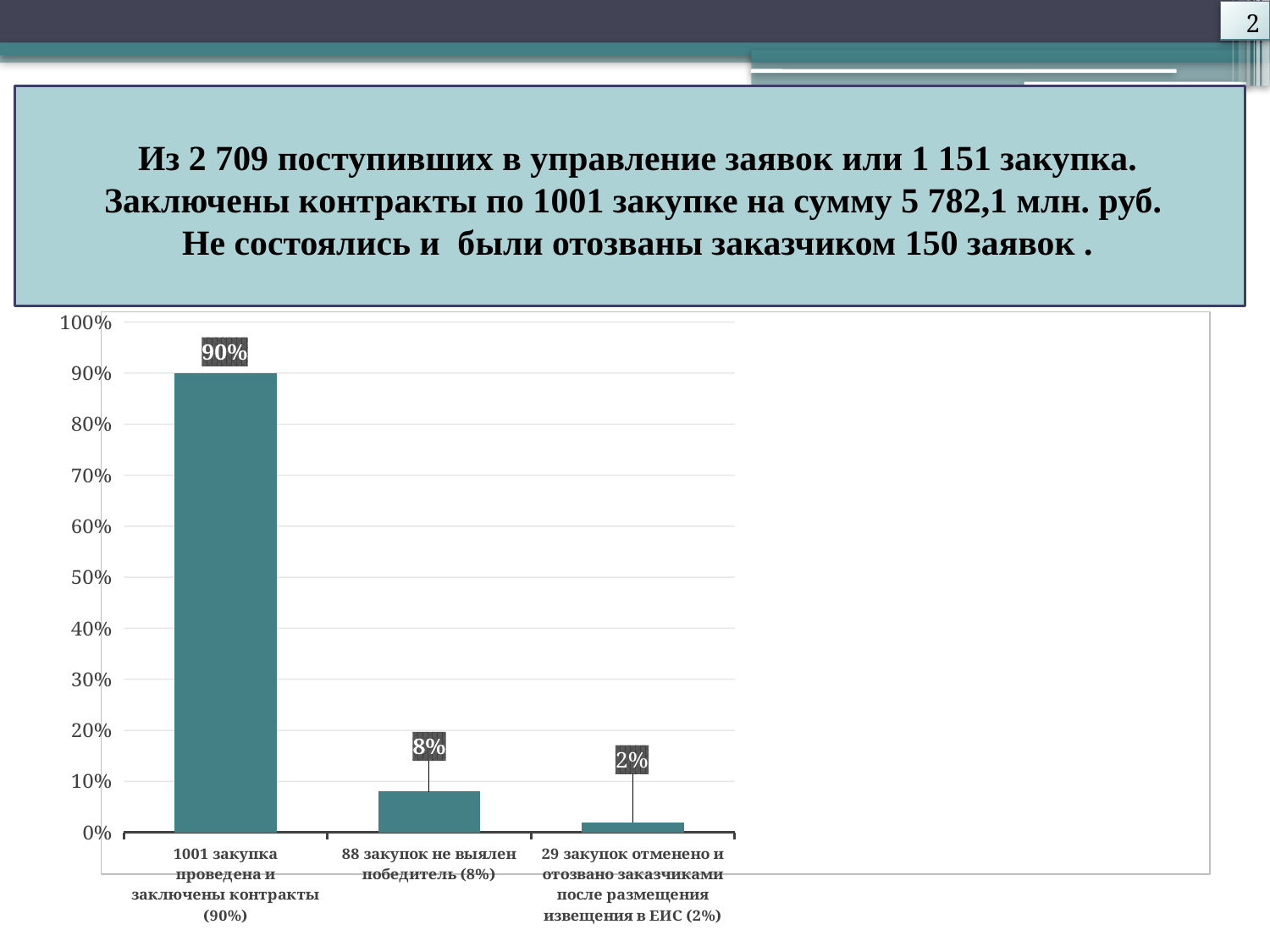
How many categories are shown on the chart? 3 What is the difference between the value for '88 закупок не выялен победитель' and the value for '29 закупок отменено и отозвано заказчиками'? 6% What is the difference between the value for '1001 закупка проведена и заключены контракты' and the value for '88 закупок не выялен победитель'? 82% Which category has the lowest value? 29 закупок отменено и отозвано заказчиками после размещения извещения в ЕИС (2%) What kind of chart is shown on the slide? bar chart Is the value for '1001 закупка проведена и заключены контракты' greater or less than 80%? greater Which category has the highest value? 1001 закупка проведена и заключены контракты (90%) Do the values rise or fall from left to right along the x axis? fall What is the value for the category '88 закупок не выялен победитель (8%)'? 8% What is the value for the category '1001 закупка проведена и заключены контракты (90%)'? 90% Which is larger: the value for '88 закупок не выялен победитель' or the value for '29 закупок отменено и отозвано заказчиками'? 88 закупок не выялен победитель (8%) What is the value for the category '29 закупок отменено и отозвано заказчиками после размещения извещения в ЕИС (2%)'? 2%